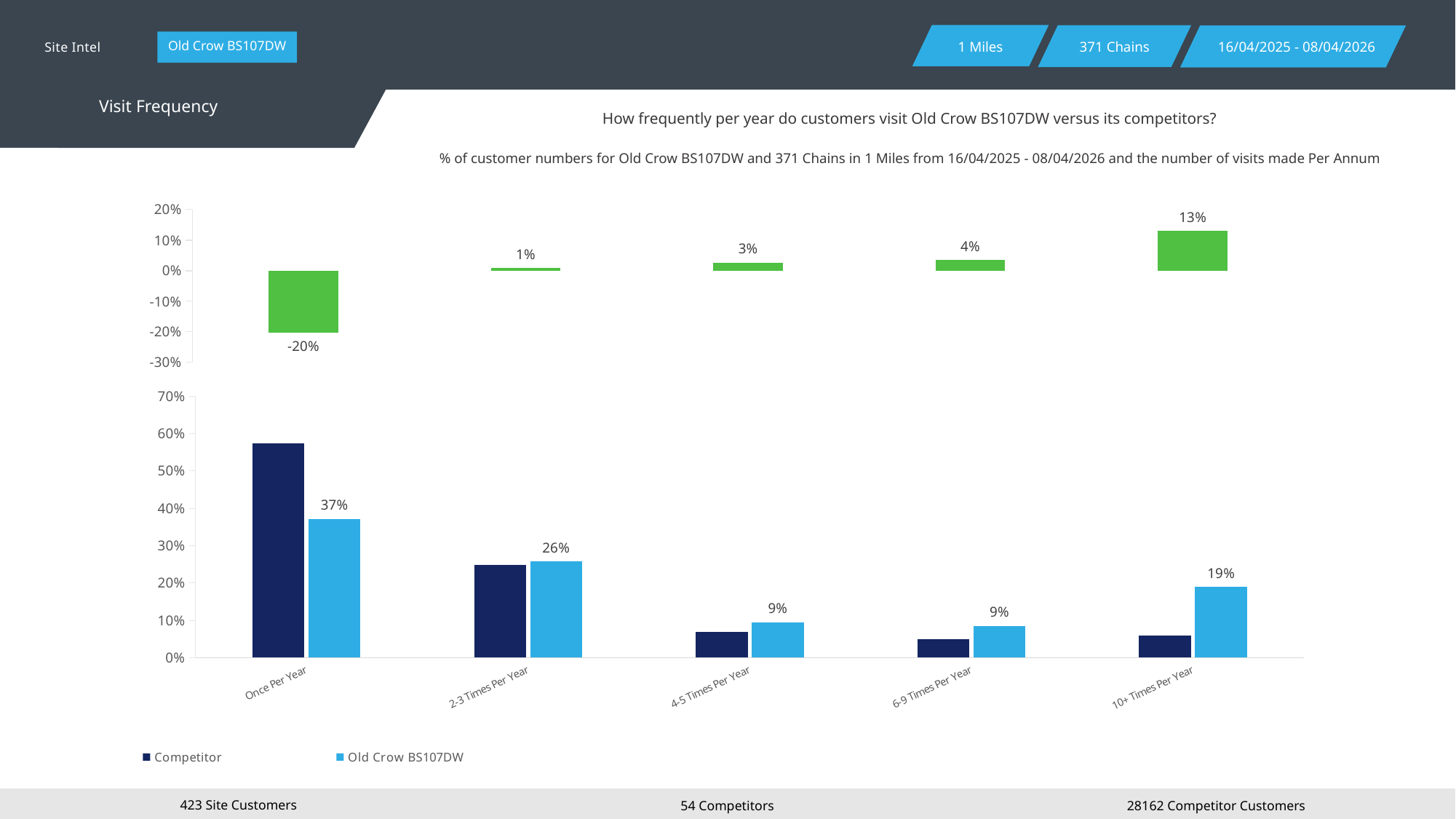
In the bottom chart, what is the difference between the Old Crow BS107DW values for Once Per Year and 2-3 Times Per Year? 11% In the top chart, which category has the lowest value? Once Per Year How many categories are shown on the x axis of the bottom chart? 5 In the bottom chart, what is the value for Old Crow BS107DW in the 10+ Times Per Year category? 19% In the top chart, what is the value shown for the 10+ Times Per Year category? 13% In the bottom chart, which category has the highest value for Old Crow BS107DW? Once Per Year How many series does the legend of the bottom chart list? 2 In the bottom chart, what is the value for Old Crow BS107DW in the Once Per Year category? 37% In the bottom chart, is the Competitor value for 6-9 Times Per Year greater or less than 10%? less In the bottom chart, which is larger for Once Per Year: the Competitor bar or the Old Crow BS107DW bar? Competitor In the bottom chart, is the Competitor value for Once Per Year greater or less than 50%? greater In the top chart, what is the value shown for the Once Per Year category? -20%